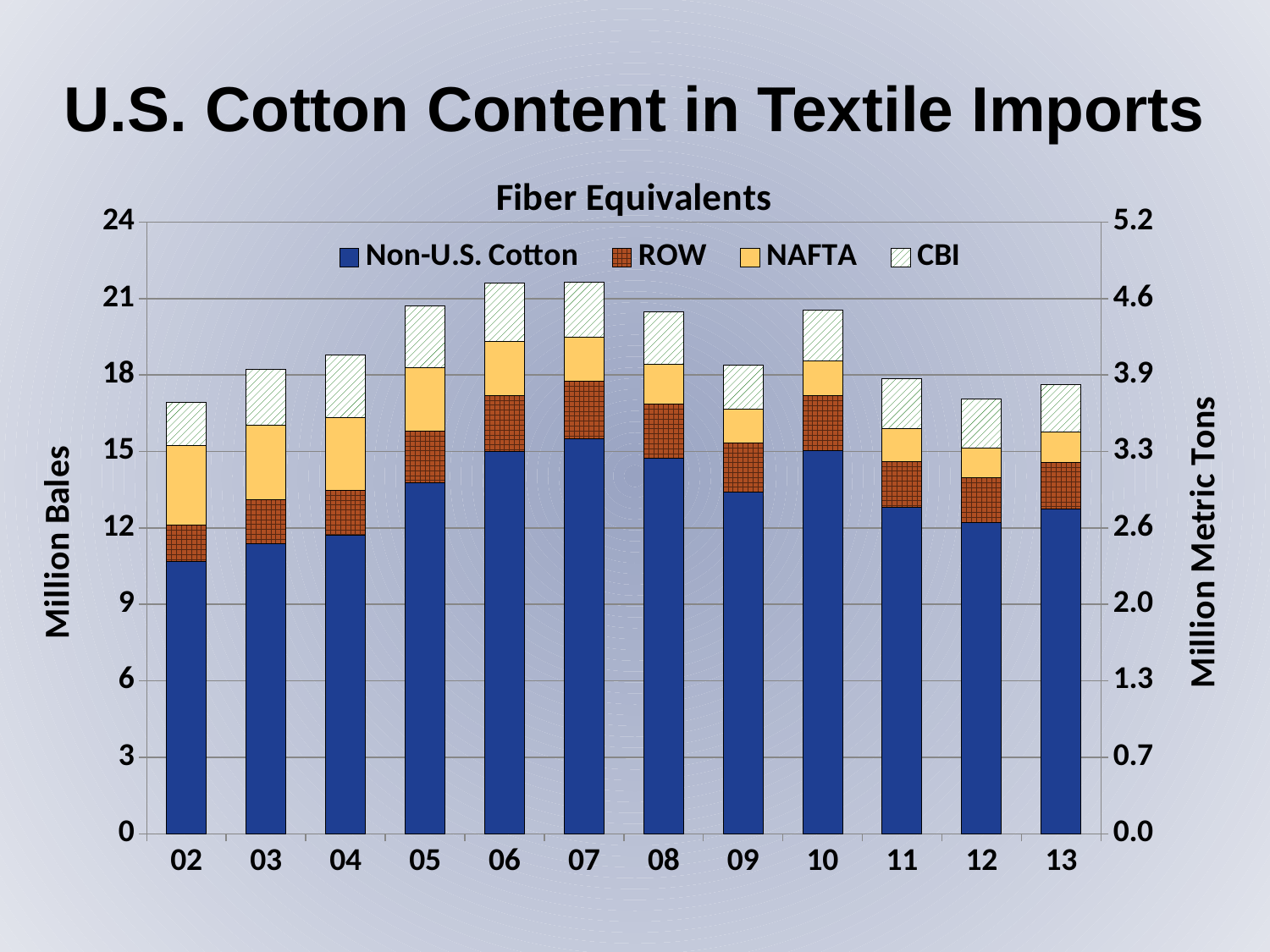
Which year has the larger Non-U.S. Cotton segment, 07 or 02? 07 Which series are listed in the chart's legend? Non-U.S. Cotton, ROW, NAFTA, CBI Is the total height of the bar for 02 greater or less than 18 million bales? less Is the total height of the bar for 05 greater or less than 18 million bales? greater What kind of chart is shown on the slide? Stacked bar chart Which year has the taller total bar, 05 or 03? 05 What is the label of the left vertical axis? Million Bales How many series does the chart's legend list? 4 Is the Non-U.S. Cotton value for 02 greater or less than 12 million bales? less How many years are shown on the x axis of the chart? 12 Do the total bar heights rise or fall from 02 to 07? rise